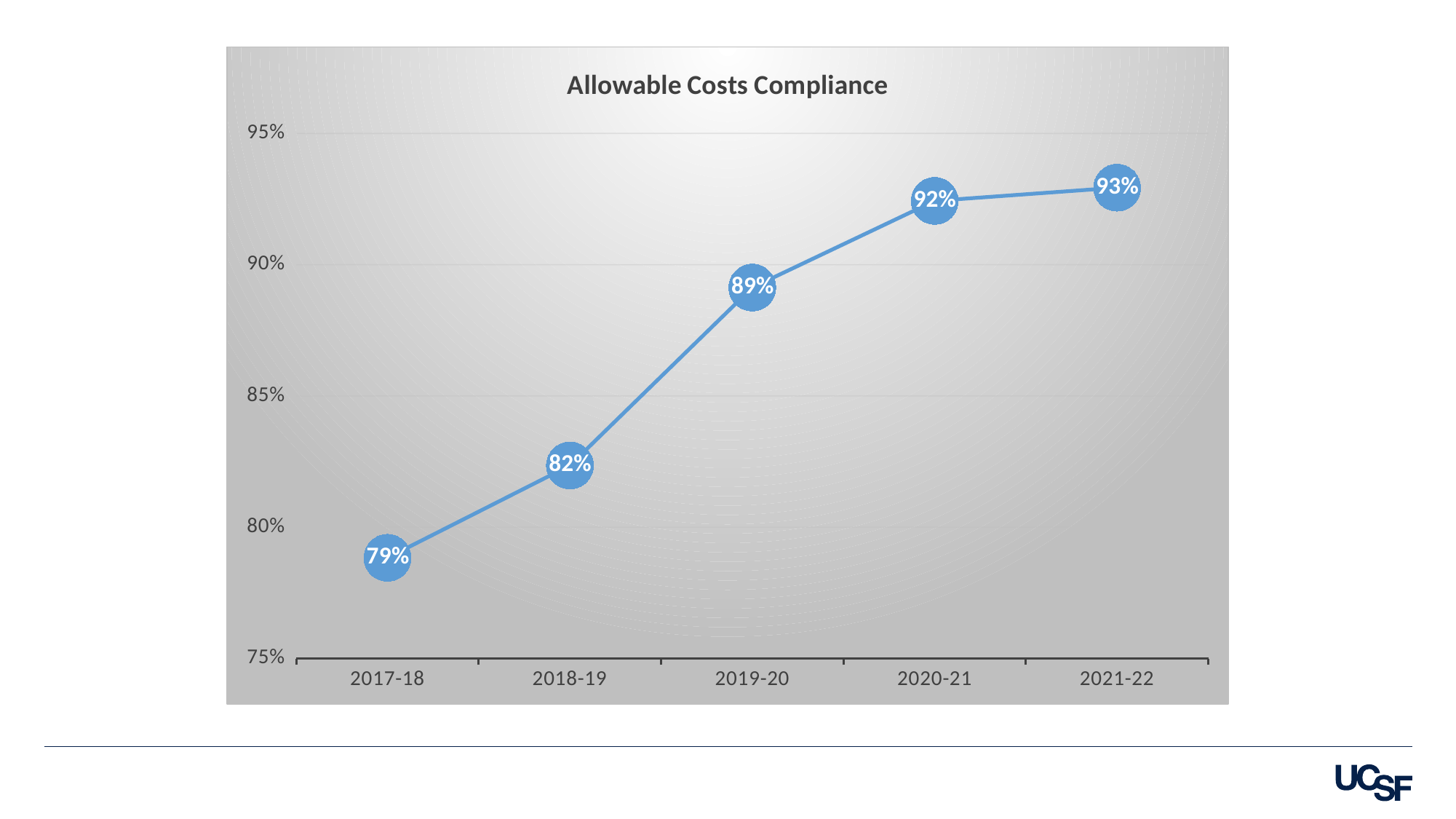
What is the Allowable Costs Compliance value for 2019-20? 89% Which year has the highest Allowable Costs Compliance value? 2021-22 What is the Allowable Costs Compliance value for 2021-22? 93% What is the difference between the 2019-20 and 2018-19 values? 7% Is the value for 2018-19 greater or less than 85%? less How many years are plotted on the chart? 5 What is the Allowable Costs Compliance value for 2017-18? 79% What is the difference between the 2021-22 and 2017-18 values? 14% Which year has the lowest Allowable Costs Compliance value? 2017-18 What kind of chart is shown on the slide? line chart Which is larger, the value for 2020-21 or the value for 2019-20? 2020-21 Do the values rise or fall from 2017-18 to 2021-22? rise